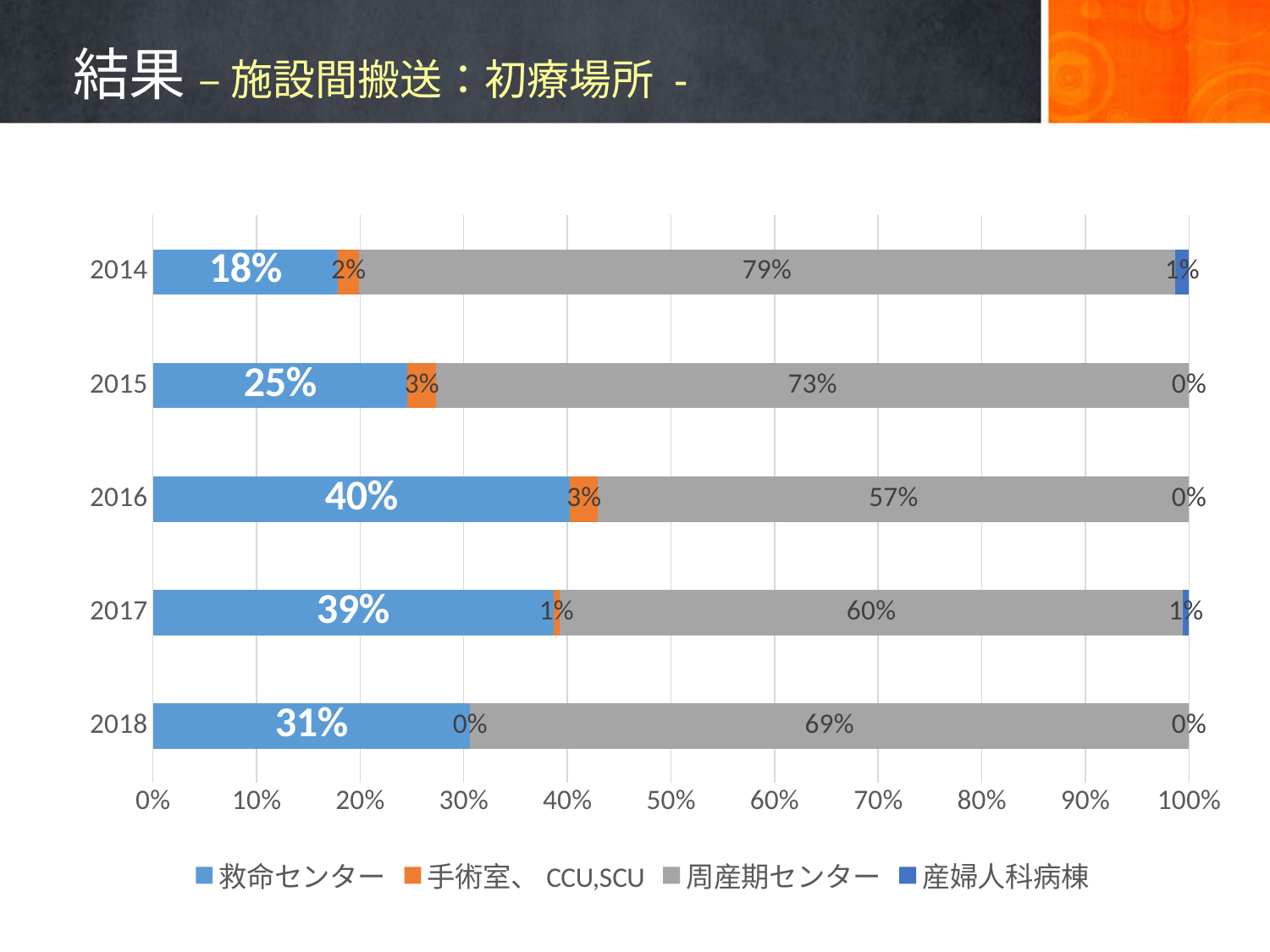
Which is larger: the 周産期センター value for 2015 or for 2018? 2015 What is the difference between the 救命センター values for 2016 and 2014? 22% Which year has the highest value for 救命センター? 2016 Which colour represents 周産期センター in the chart? Gray How many series does the legend list? 4 What is the value for 救命センター in 2016? 40% What is the value for 周産期センター in 2014? 79% What is the value for 手術室、CCU,SCU in 2015? 3% Which year has the lowest value for 周産期センター? 2016 What kind of chart is shown on the slide? Stacked bar chart What is the value for 産婦人科病棟 in 2017? 1% How many years are shown on the chart? 5